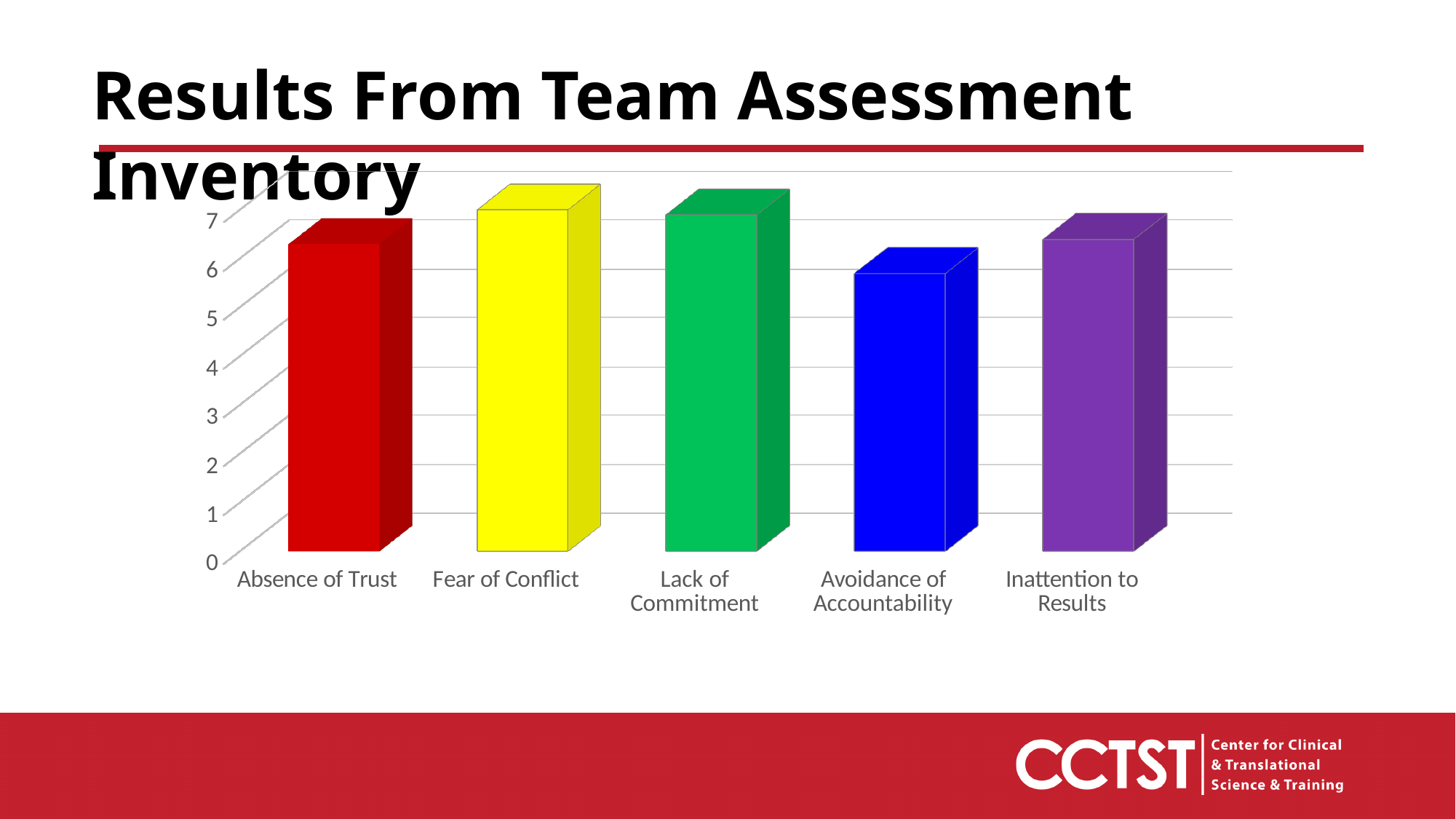
Is the value for Avoidance of Accountability greater or less than 7? less Is the value for Absence of Trust greater or less than 7? less Is the value for Fear of Conflict greater or less than 6? greater Which is larger, the value for Fear of Conflict or the value for Avoidance of Accountability? Fear of Conflict How many categories are plotted in the chart? 5 Which category has the lowest value in the chart? Avoidance of Accountability What kind of chart is shown on the slide? bar chart Which is larger, the value for Absence of Trust or the value for Avoidance of Accountability? Absence of Trust What colour is the bar for Absence of Trust? red